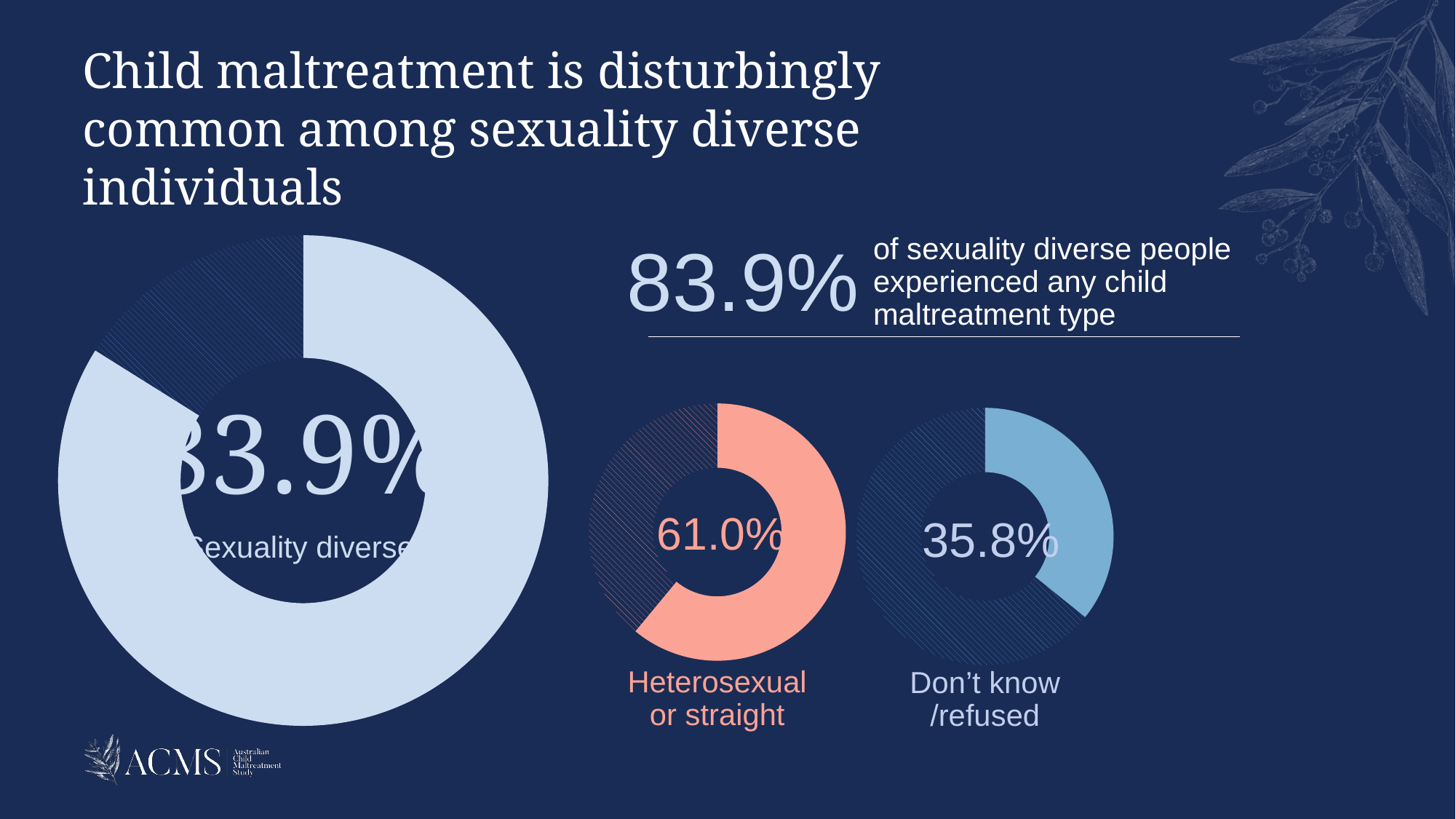
What is the difference in percentage points between the Heterosexual or straight chart and the Don't know/refused chart? 25.2 What is the difference in percentage points between the Sexuality diverse chart and the Heterosexual or straight chart? 22.9 How many donut charts are shown on the slide? 3 What value is shown in the donut chart labelled 'Heterosexual or straight'? 61.0% Is the value shown in the Don't know/refused donut chart greater or less than 50%? less What colour is the filled portion of the Heterosexual or straight donut chart? Salmon/orange What kind of chart is used to display the percentages on this slide? Donut (pie) chart Which of the three donut charts shows the lowest percentage? Don't know/refused Which is larger: the value for Heterosexual or straight or the value for Don't know/refused? Heterosexual or straight Which of the three donut charts shows the highest percentage? Sexuality diverse What value is shown in the donut chart labelled 'Don't know/refused'? 35.8% What percentage of sexuality diverse people experienced any child maltreatment type, according to the large donut chart on the left? 83.9%